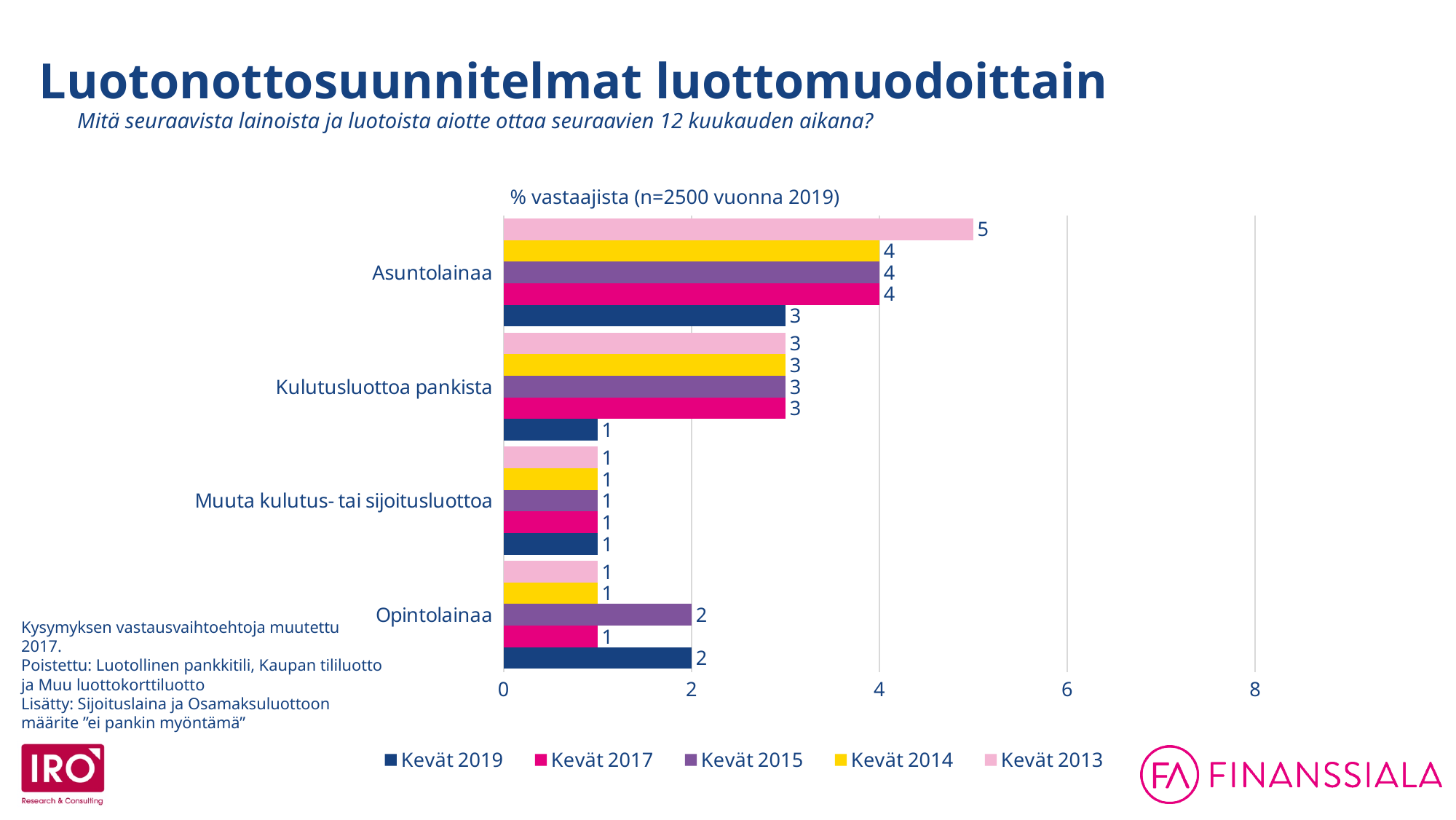
What type of chart is shown on the slide? bar chart How many categories are shown on the chart? 4 What is the title shown above the plot area of the chart? % vastaajista (n=2500 vuonna 2019) What is the difference between the Kevät 2013 and Kevät 2019 values for Asuntolainaa? 2 What is the value for Asuntolainaa in Kevät 2019? 3 What is the value for Asuntolainaa in Kevät 2013? 5 Which is larger for Opintolainaa: the Kevät 2019 value or the Kevät 2017 value? Kevät 2019 Which category has the highest value in Kevät 2013? Asuntolainaa What is the value for Kulutusluottoa pankista in Kevät 2019? 1 What is the value for Opintolainaa in Kevät 2015? 2 How many series does the legend list? 5 What is the difference between the Kevät 2017 and Kevät 2019 values for Kulutusluottoa pankista? 2